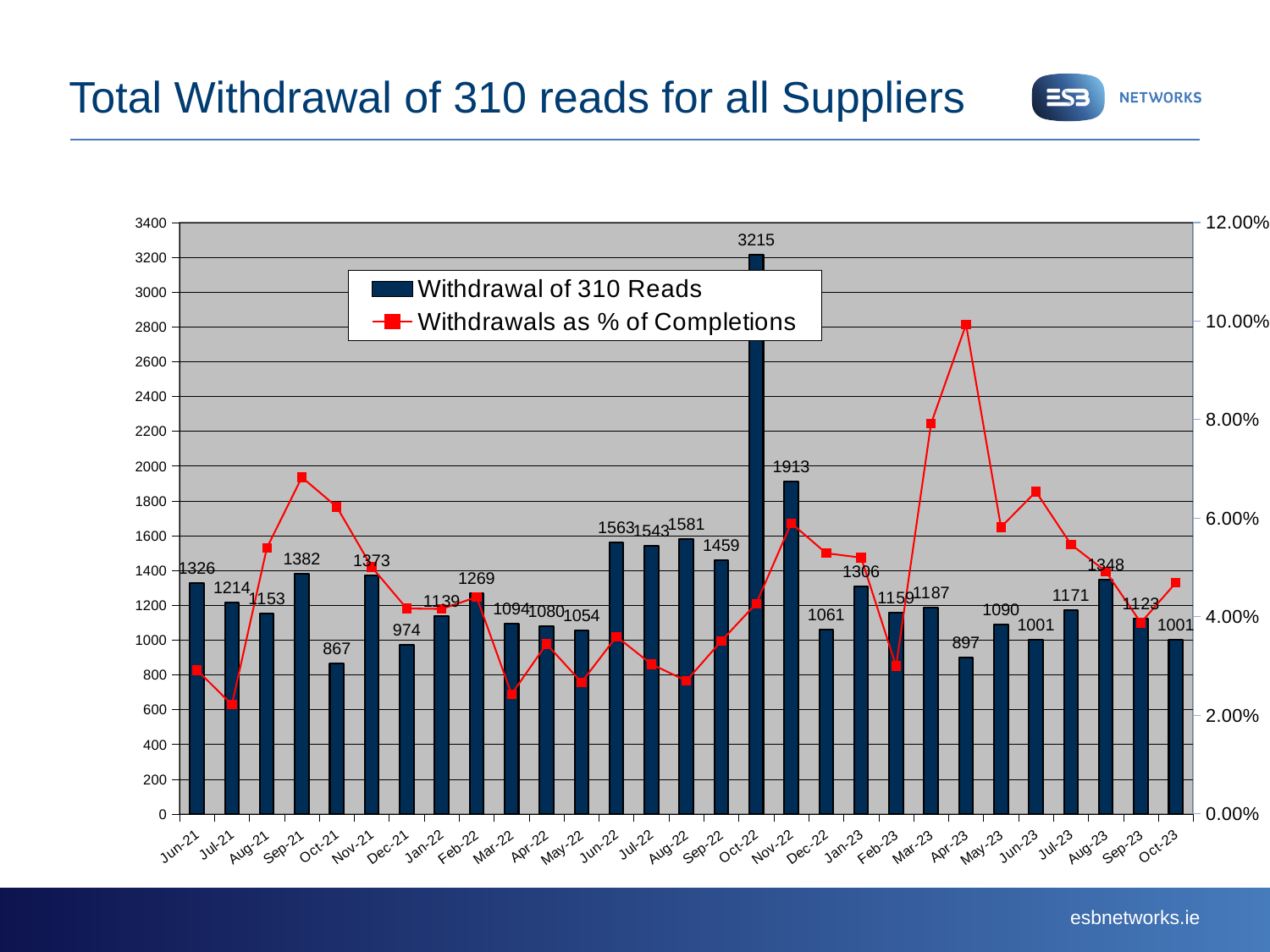
Which month has a higher Withdrawal of 310 Reads, Aug-22 or Sep-22? Aug-22 What is the value of Withdrawal of 310 Reads for Feb-22? 1269 Which month has the lowest Withdrawal of 310 Reads? Oct-21 What colour is the Withdrawals as % of Completions line? Red What is the value of Withdrawal of 310 Reads for Apr-23? 897 How many months are shown on the x axis of the chart? 29 Which month has the highest Withdrawal of 310 Reads? Oct-22 Is the value of Withdrawals as % of Completions for Apr-23 greater or less than 8.00%? greater What is the value of Withdrawal of 310 Reads for Oct-22? 3215 Is the value of Withdrawals as % of Completions for Jul-21 greater or less than 4.00%? less What is the difference in Withdrawal of 310 Reads between Oct-22 and Nov-22? 1302 How many series does the legend list? 2